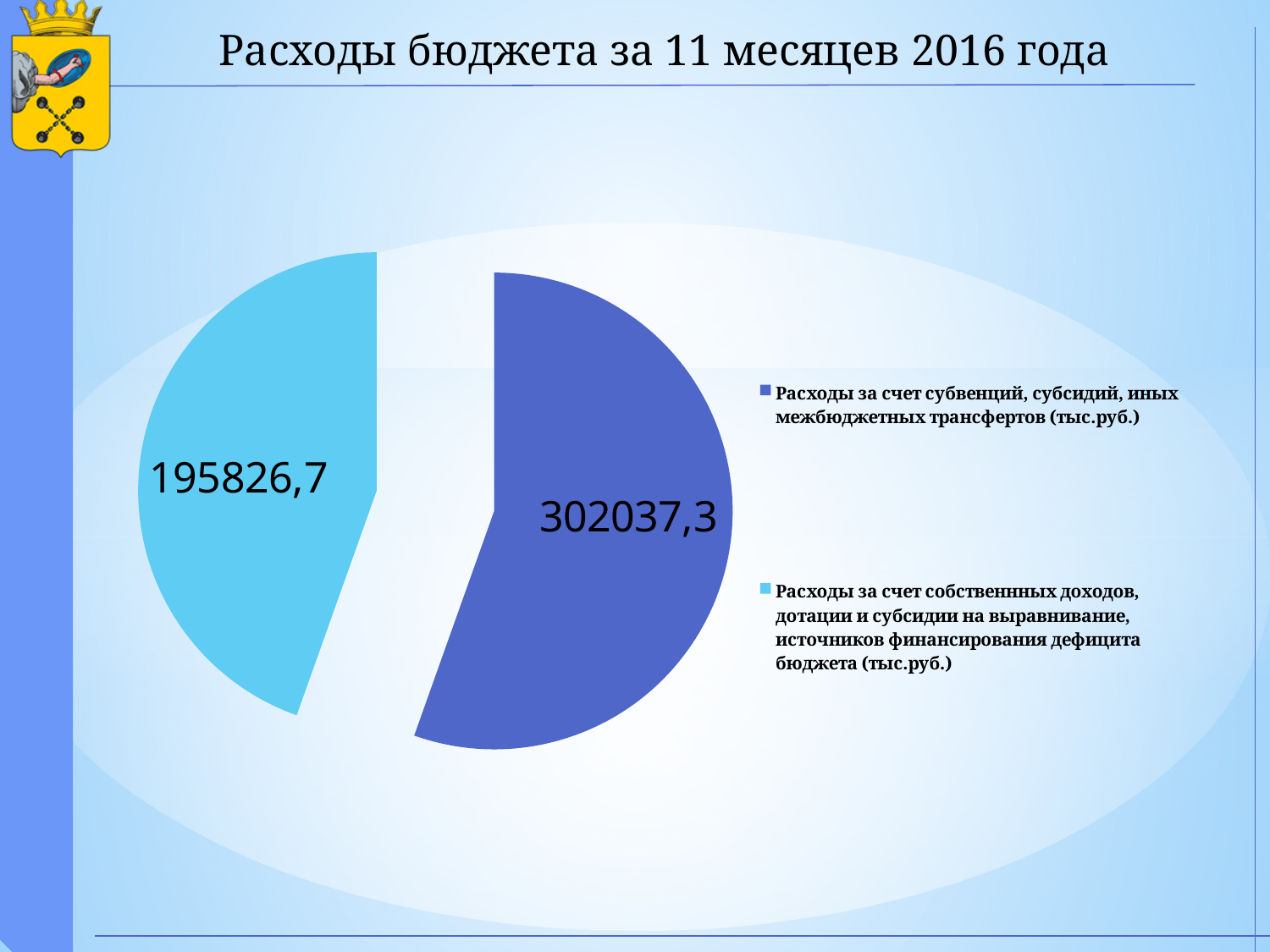
What is the value for 'Расходы за счет субвенций, субсидий, иных межбюджетных трансфертов (тыс.руб.)'? 302037,3 How many entries does the legend list? 2 Which is larger: expenses from subventions and subsidies (302037,3) or expenses from own revenues (195826,7)? Расходы за счет субвенций, субсидий, иных межбюджетных трансфертов (тыс.руб.) What type of chart is shown on the slide? Pie chart Which category has the largest slice of the pie? Расходы за счет субвенций, субсидий, иных межбюджетных трансфертов (тыс.руб.) What is the total of the two values shown on the pie chart? 497864,0 What colour is the slice labelled 302037,3? Dark blue How many slices does the pie chart have? 2 What is the value for 'Расходы за счет собственнных доходов, дотации и субсидии на выравнивание, источников финансирования дефицита бюджета (тыс.руб.)'? 195826,7 Which category has the smallest slice of the pie? Расходы за счет собственнных доходов, дотации и субсидии на выравнивание, источников финансирования дефицита бюджета (тыс.руб.) What is the title of the slide containing the pie chart? Расходы бюджета за 11 месяцев 2016 года What is the difference between the two values shown on the pie chart? 106210,6